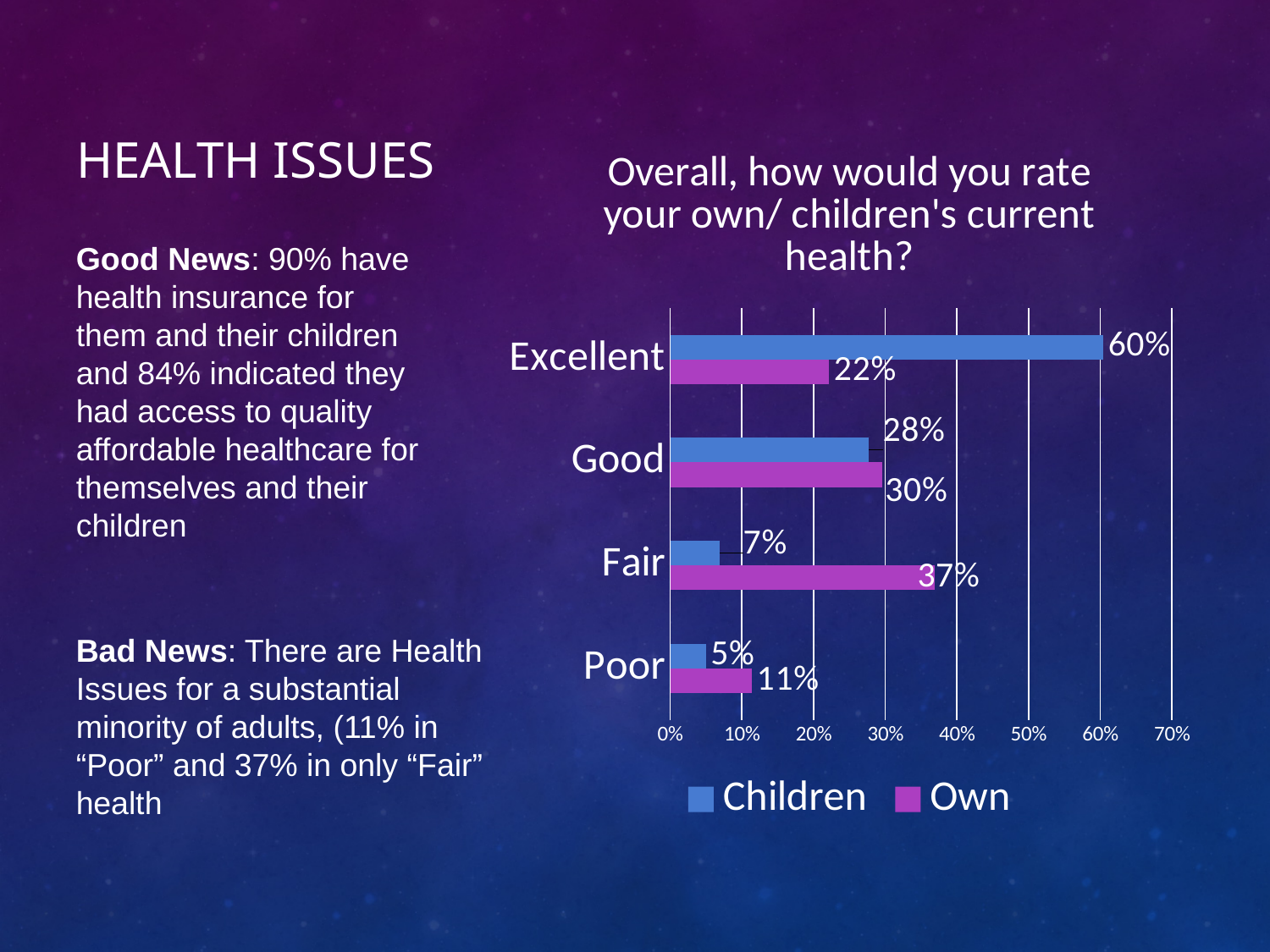
Which category has the highest value for the Children series? Excellent How many series does the legend list? 2 Which is larger for the Fair category, Children or Own? Own Which category has the lowest value for the Own series? Poor What is the title of the chart? Overall, how would you rate your own/ children's current health? What is the value for Own in the Poor category? 11% What kind of chart is shown on the slide? Bar chart What percentage of respondents rated their own health as Fair? 37% What is the value for Children in the Good category? 28% What percentage of respondents rated their children's health as Excellent? 60% How many categories are shown on the chart? 4 What is the difference between the Children and Own values for Excellent? 38%